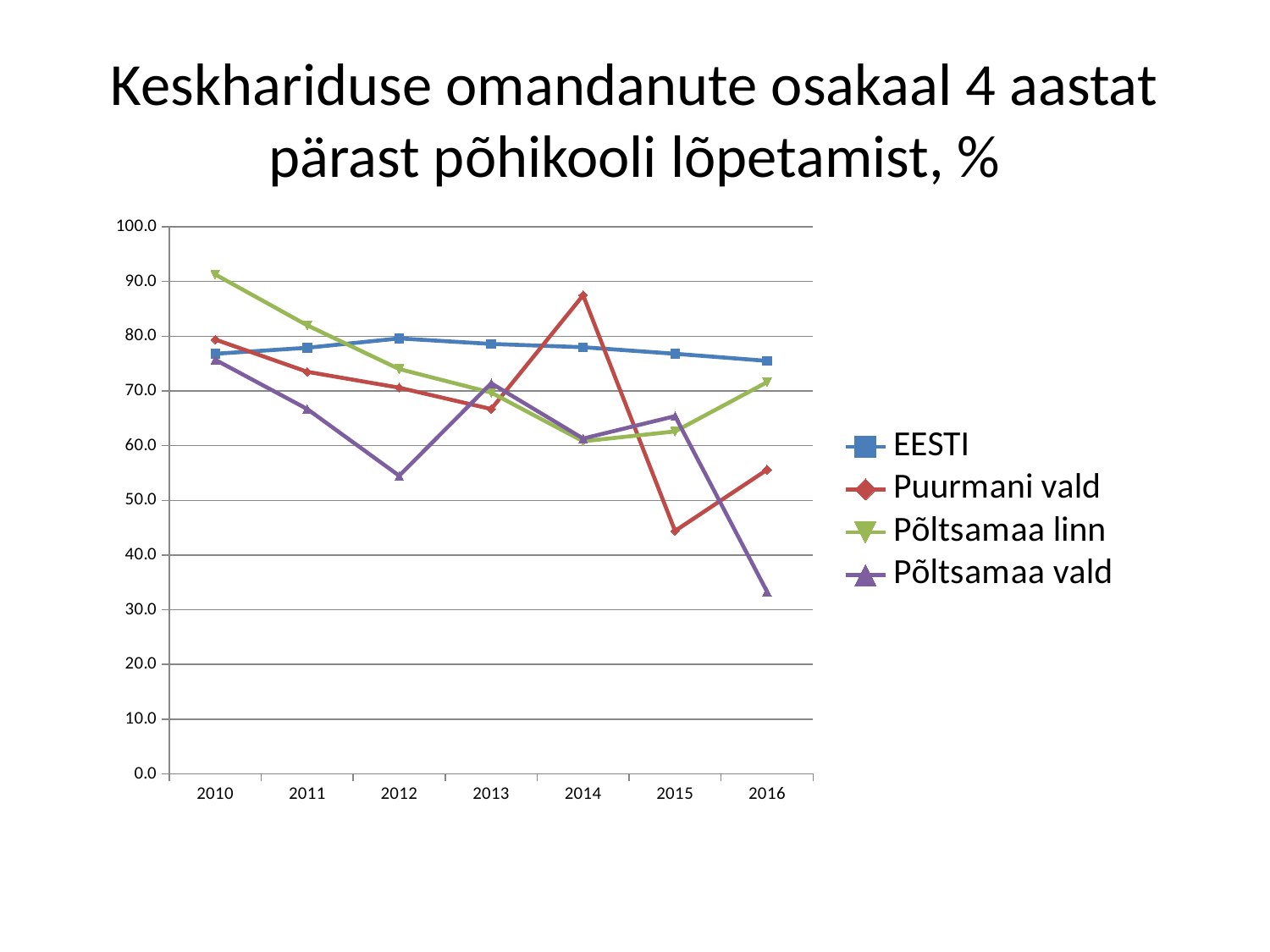
Which series has the lowest value in 2016? Põltsamaa vald In which year does Puurmani vald have its lowest value? 2015 Is the value for Põltsamaa linn in 2010 greater or less than 80? greater Is the value for Põltsamaa vald in 2016 greater or less than 40? less Which series is shown with the blue line and square markers? EESTI How many series does the legend list? 4 How many years are shown on the x axis? 7 What kind of chart is shown on the slide? line chart Which series has the highest value in 2010? Põltsamaa linn In 2015, which is larger: the value for EESTI or the value for Puurmani vald? EESTI Is the value for Puurmani vald in 2014 greater or less than 80? greater Do the values for Põltsamaa linn rise or fall from 2010 to 2014? fall